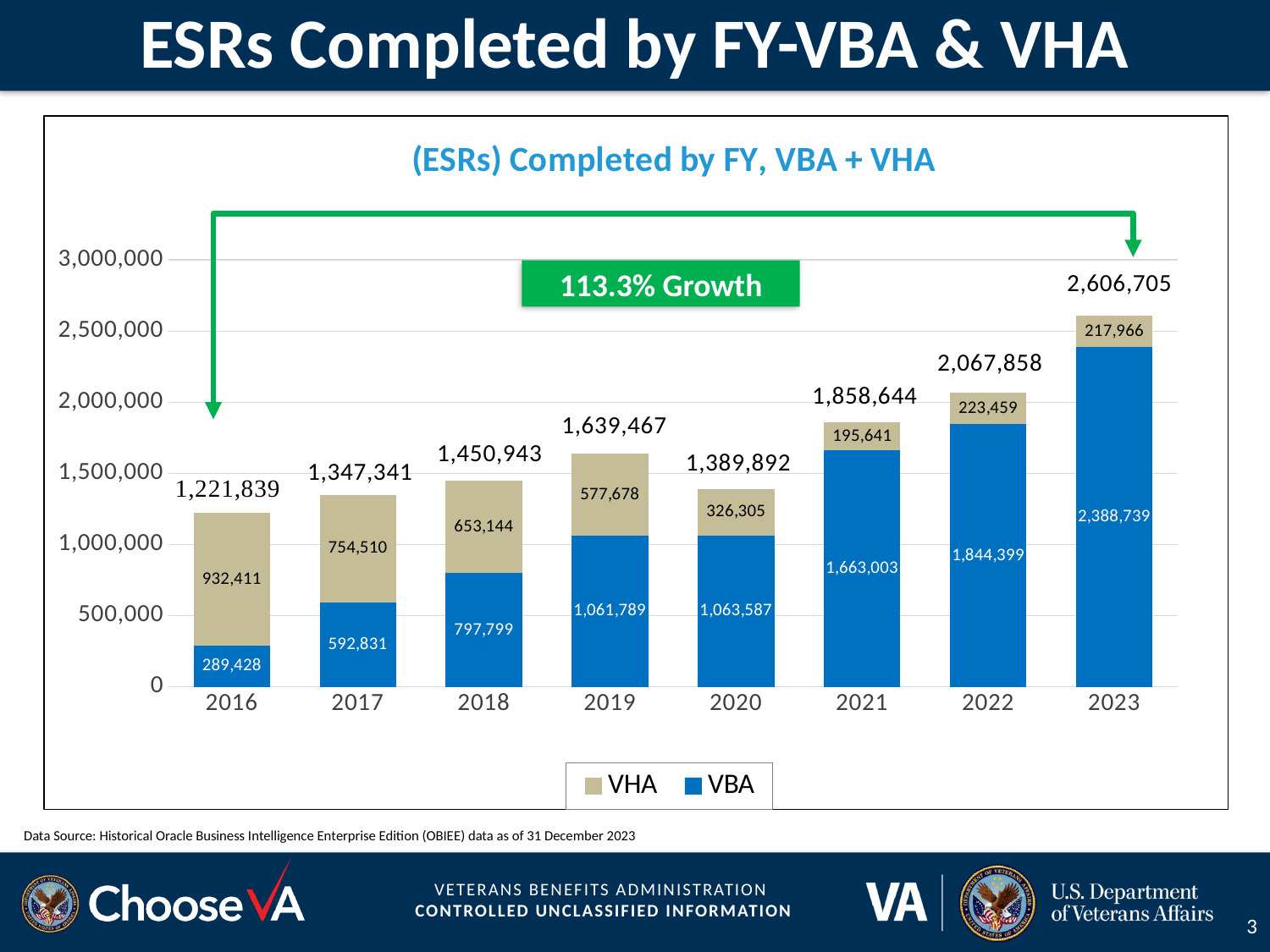
Does the VBA value rise or fall from 2016 to 2023? rise Which year has the lowest VHA value? 2021 Which year has the highest VHA value? 2016 What is the VHA value for 2019? 577,678 What is the total number of ESRs completed in 2022? 2,067,858 What is the difference between the VBA values for 2023 and 2022? 544,340 Which year has the highest total ESRs completed? 2023 What is the VBA value for 2016? 289,428 Is the total for 2020 greater or less than 1,500,000? less In 2017, which is larger, the VBA value or the VHA value? VHA What is the difference between the total for 2023 and the total for 2016? 1,384,866 How many years are shown on the x axis? 8